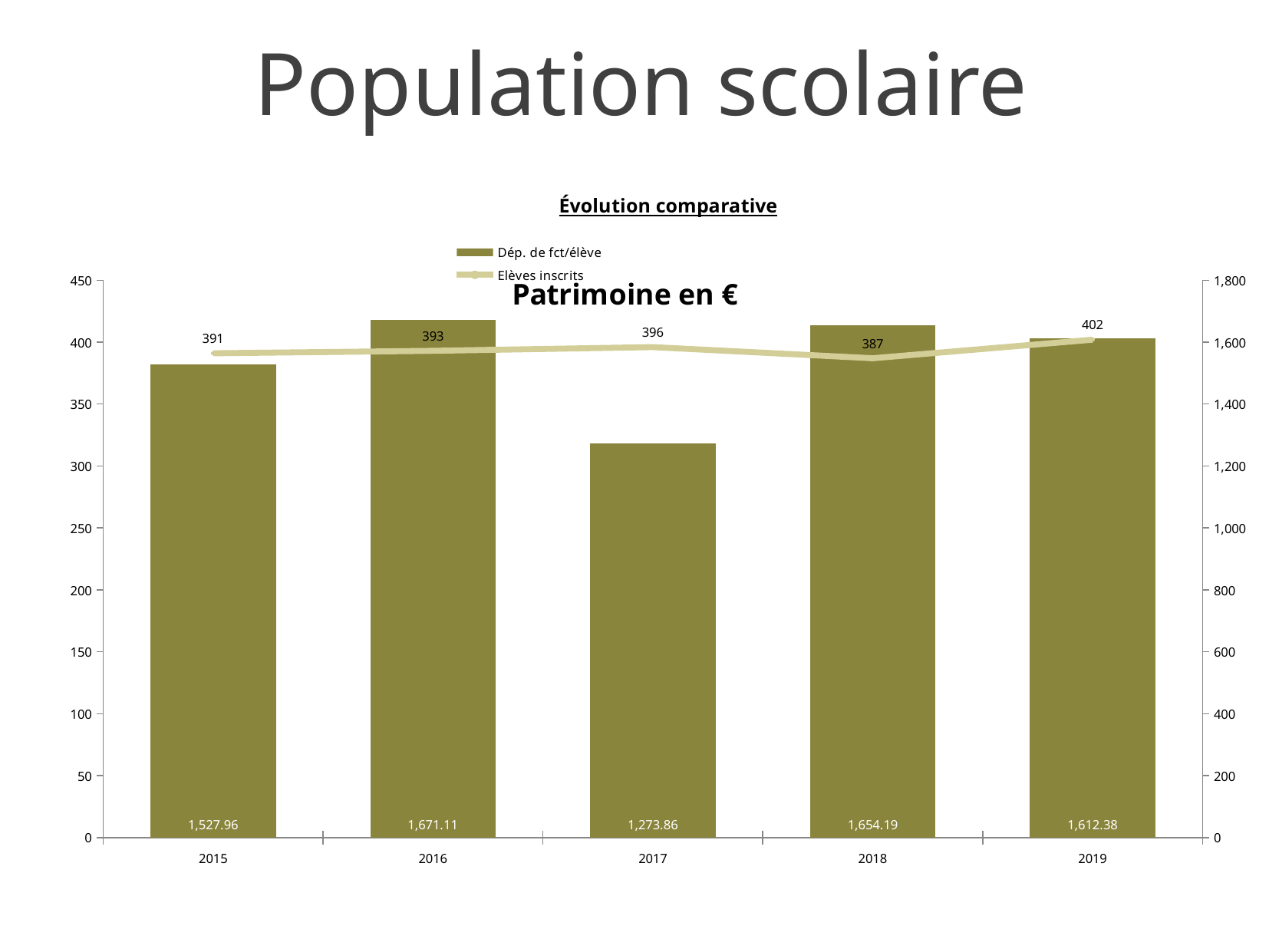
Which year has the highest Dép. de fct/élève? 2016 Which year has the highest number of Elèves inscrits? 2019 Which year has the lowest Dép. de fct/élève? 2017 How many series does the legend list? 2 What kind of chart is used for the Dép. de fct/élève series? Bar chart What is the difference in Elèves inscrits between 2019 and 2015? 11 How many years are shown on the x axis? 5 What is the value of Dép. de fct/élève for 2016? 1,671.11 Is the Dép. de fct/élève higher in 2018 or in 2019? 2018 What is the title of the chart? Évolution comparative Which year has the lowest number of Elèves inscrits? 2018 How many Elèves inscrits are shown for 2018? 387